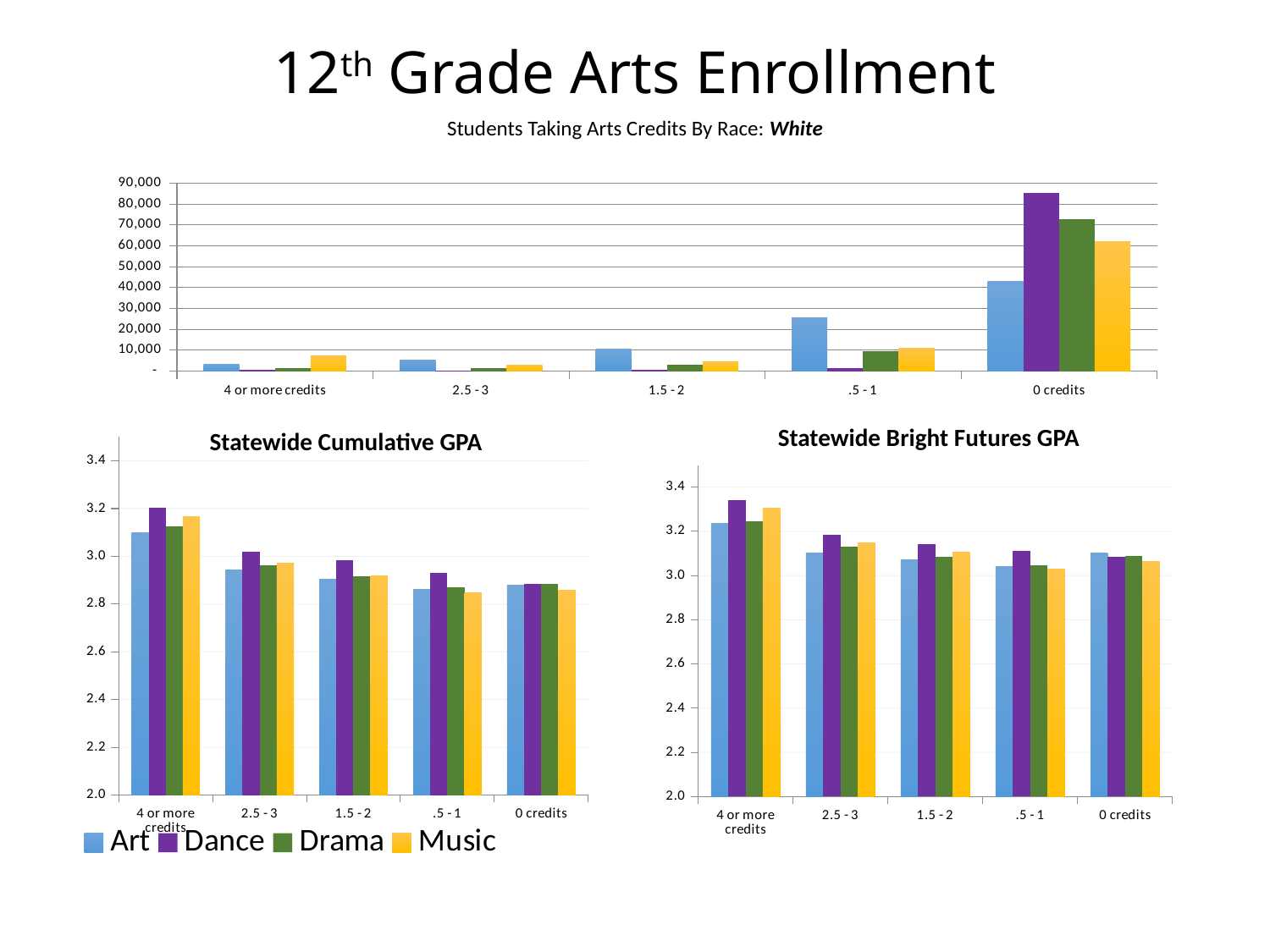
In the top chart (Students Taking Arts Credits By Race: White), which series has the highest value in the 0 credits category? Dance How many series does the legend list for the charts on this slide? 4 In the top chart (Students Taking Arts Credits By Race: White), which credit category has the tallest bars? 0 credits In the top chart (Students Taking Arts Credits By Race: White), is the value for Art at .5 - 1 credits greater or less than 20,000? greater In the top chart (Students Taking Arts Credits By Race: White), is the value for Music at 4 or more credits greater or less than 10,000? less How many credit categories are shown on the x axis of the Statewide Bright Futures GPA chart? 5 In the Statewide Cumulative GPA chart, do the GPA values generally rise or fall moving from 4 or more credits to 0 credits? fall In the Statewide Cumulative GPA chart, is the value for Music at .5 - 1 credits greater or less than 3.0? less In the top chart (Students Taking Arts Credits By Race: White), which series has the lowest value in the 0 credits category? Art In the Statewide Cumulative GPA chart, which series has the highest value in the 4 or more credits category? Dance